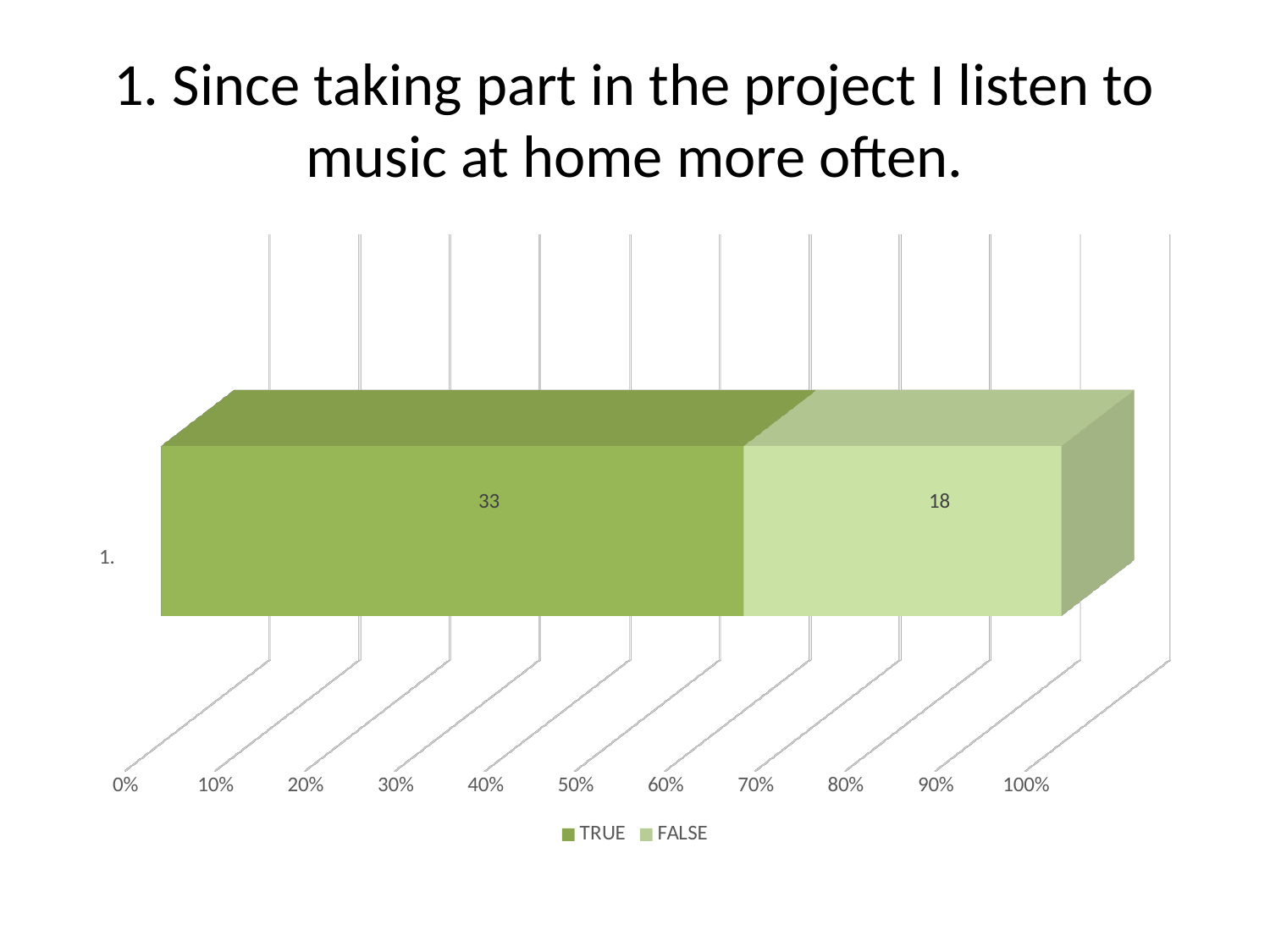
What is the total of the TRUE and FALSE values in the stacked bar? 51 How many categories are plotted on the chart? 1 Which series has the smallest value? FALSE What is the title of the slide containing the chart? 1. Since taking part in the project I listen to music at home more often. What is the difference between the TRUE value and the FALSE value? 15 How many series does the legend list? 2 What are the two entries in the chart legend? TRUE and FALSE What is the value of the FALSE series for category 1.? 18 Which series has the larger value, TRUE or FALSE? TRUE Does the TRUE segment of the bar end at a point greater or less than 50% on the axis? greater What is the value of the TRUE series for category 1.? 33 What kind of chart is shown on the slide? Bar chart